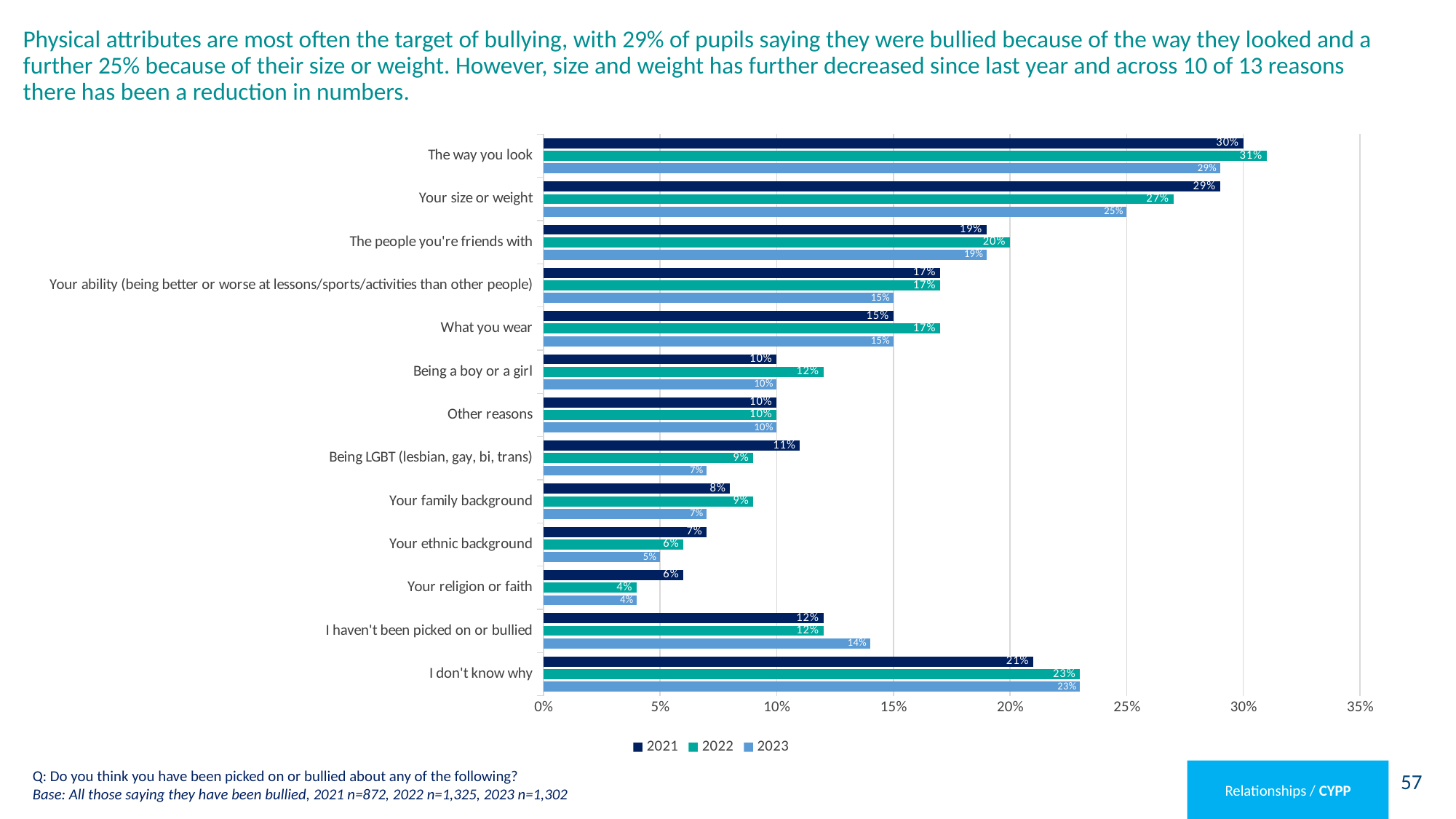
What is the difference between the 2022 and 2023 values for 'Your size or weight'? 2% How many categories are shown on the chart? 13 Is the 2021 value for 'The people you're friends with' greater or less than 15%? greater How many series does the legend list? 3 What is the 2021 value for 'I don't know why'? 21% Which category has the highest 2023 value? The way you look Which years are listed in the chart legend? 2021, 2022, 2023 What is the 2023 value for 'Your size or weight'? 25% Which is larger for 'I haven't been picked on or bullied': the 2021 value or the 2023 value? 2023 Which category has the lowest 2022 value? Your religion or faith What kind of chart is shown on the slide? Bar chart What is the 2022 value for 'The way you look'? 31%